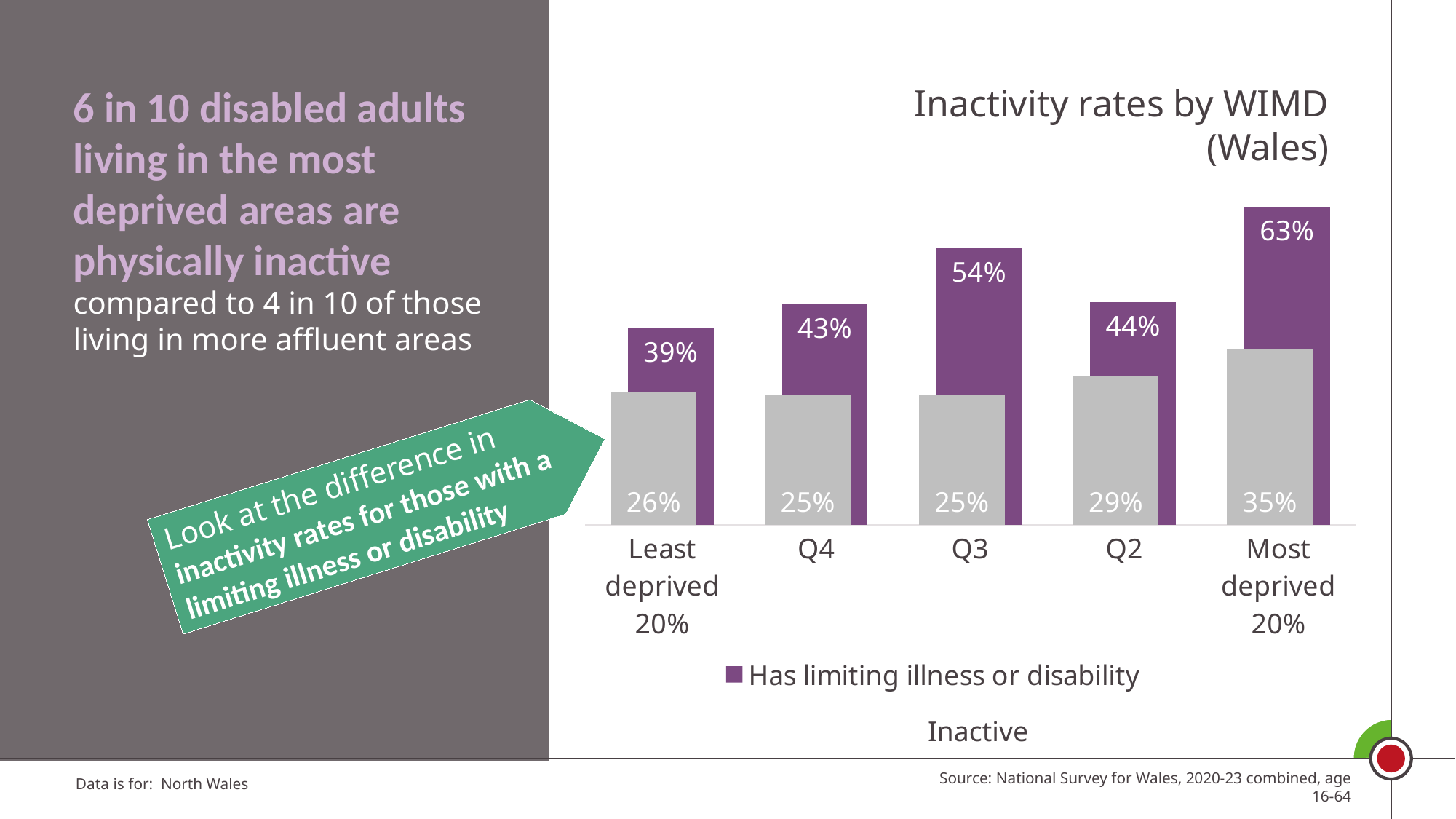
Which WIMD group has the highest inactivity rate for those with a limiting illness or disability? Most deprived 20% What type of chart is shown on the slide? Bar chart Which is larger: the 'Has limiting illness or disability' value for Q3 or for Q2? Q3 How many WIMD categories are shown on the x axis? 5 What is the title of the chart? Inactivity rates by WIMD (Wales) What value is shown on the grey bar for Q2? 29% What is the difference in the 'Has limiting illness or disability' inactivity rate between the Most deprived 20% and the Least deprived 20%? 24% What value is shown on the grey bar for the Least deprived 20% group? 26% What is the inactivity rate for those with a limiting illness or disability in Q3? 54% Which WIMD group has the lowest inactivity rate for those with a limiting illness or disability? Least deprived 20% What is the difference between the purple and grey bar values for the Most deprived 20% group? 28% What is the inactivity rate for those with a limiting illness or disability in the Most deprived 20% group? 63%